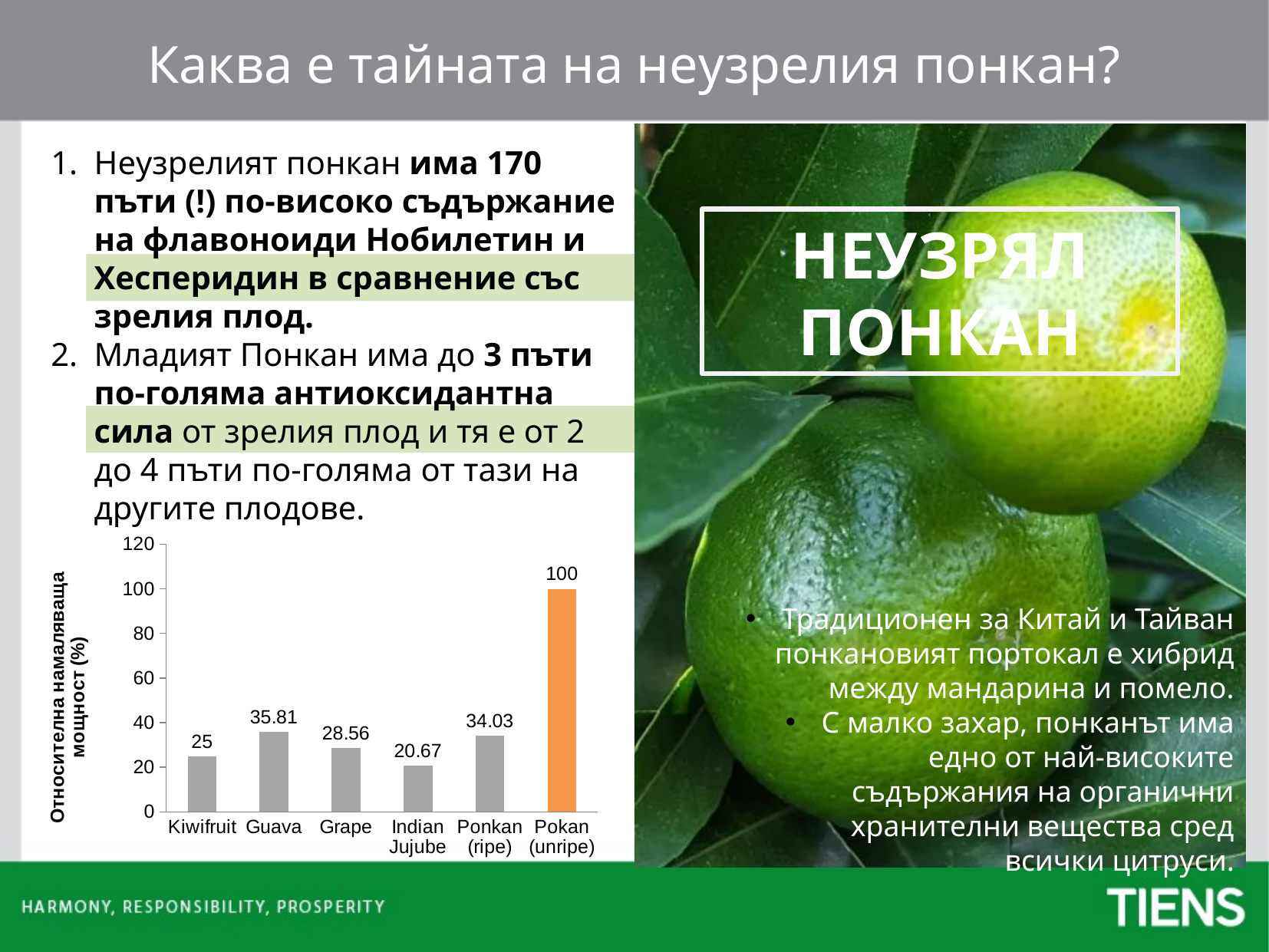
How many categories are shown on the x axis of the bar chart? 6 What value is shown for Guava in the bar chart? 35.81 What is the difference between the values for Pokan (unripe) and Ponkan (ripe)? 65.97 What value is shown for Kiwifruit in the bar chart? 25 What is the label of the y axis of the bar chart? Относителна намаляваща мощност (%) Which is larger in the bar chart, the value for Grape or the value for Kiwifruit? Grape Which category has the lowest value in the bar chart? Indian Jujube What value is shown for Indian Jujube in the bar chart? 20.67 Is the value for Guava greater or less than 40? less Which category has the highest value in the bar chart? Pokan (unripe) What value is shown for Ponkan (ripe) in the bar chart? 34.03 What type of chart is shown on the slide? bar chart